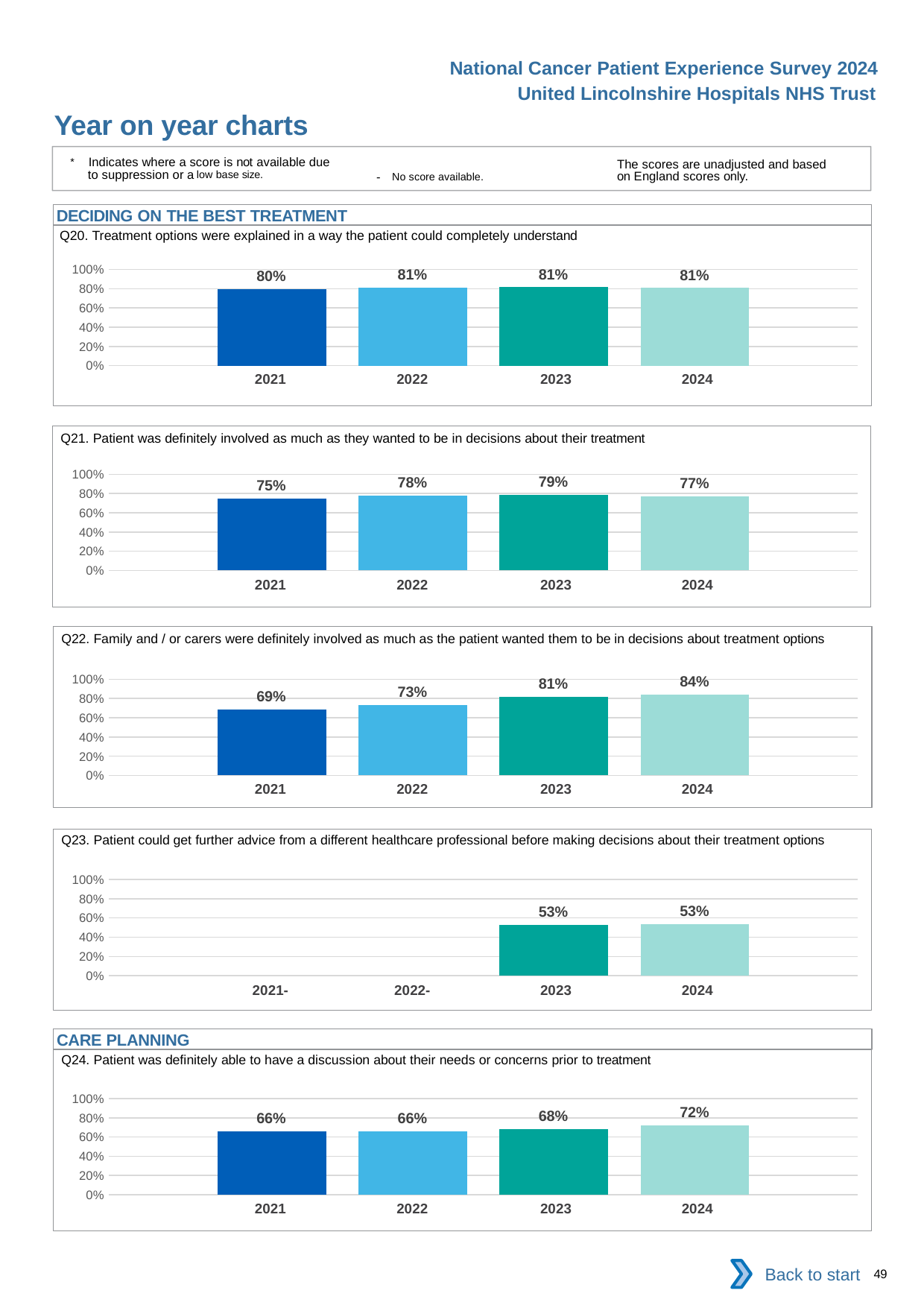
In the Q22 chart, what is the difference between the 2024 value and the 2021 value? 15% In the Q20 chart, what is the value for 2021? 80% In the Q21 chart, which year has the lowest value? 2021 In the Q21 chart, which year has the highest value? 2023 What kind of chart is the Q20 chart? bar chart How many charts are shown on the slide? 5 In the Q24 chart, is the value for 2022 larger or smaller than the value for 2023? smaller In the Q22 chart, do the values rise or fall from 2021 to 2024? rise In the Q24 chart, which year has the highest value? 2024 In the Q23 chart, how many years have a bar plotted? 2 In the Q23 chart, what is the value for 2023? 53% In the Q24 chart, what is the difference between the 2024 value and the 2023 value? 4%